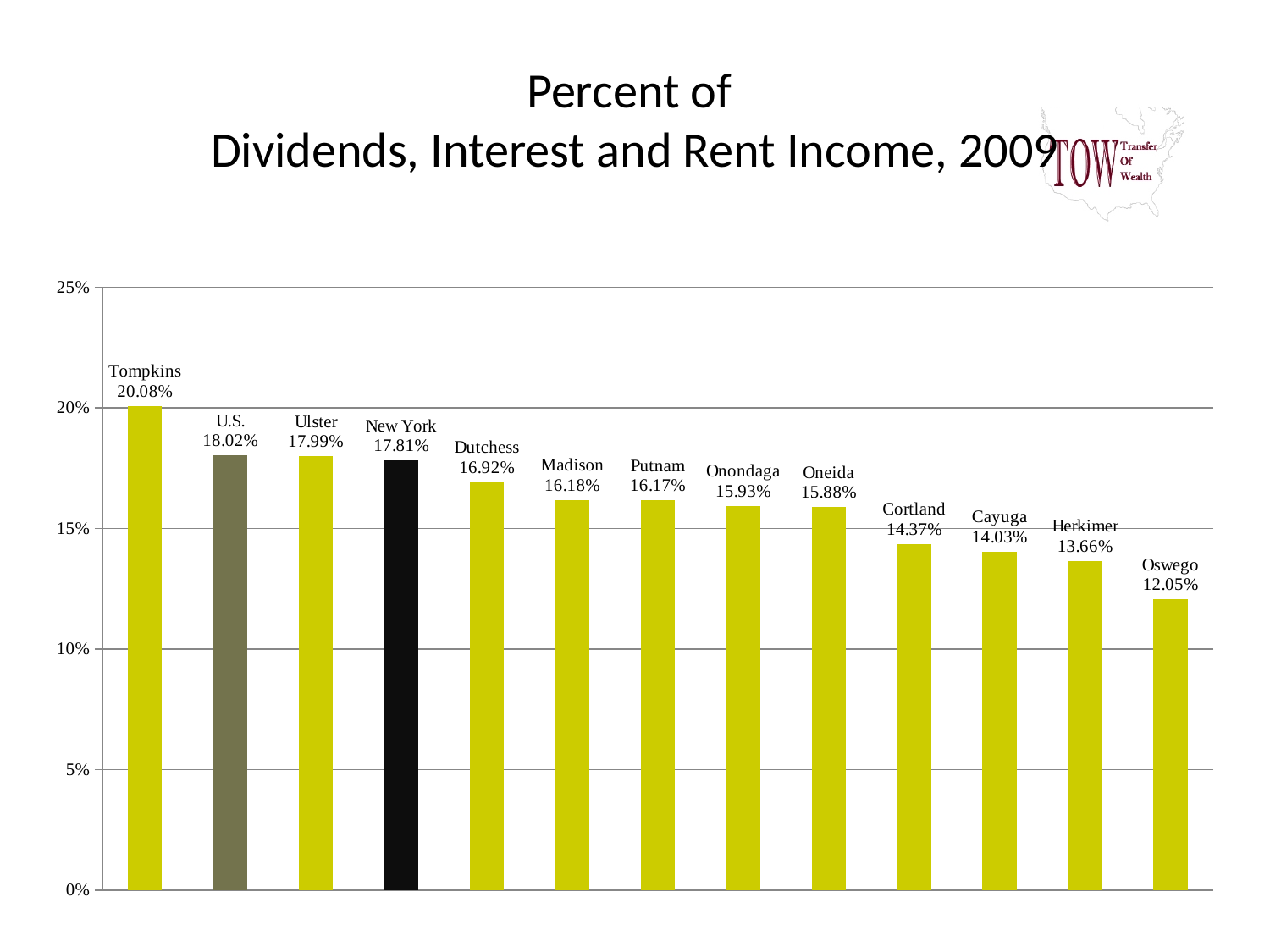
What is the difference between the values for Tompkins and Oswego? 8.03% Do the values rise or fall from left to right along the x axis? fall What is the value for New York? 17.81% What kind of chart is shown on the slide? bar chart What is the value for Tompkins? 20.08% Which category has the lowest value? Oswego Which category has the highest value? Tompkins What is the value for Oneida? 15.88% How many bars are shown in the chart? 13 Is the value for Herkimer greater or less than 15%? less What is the difference between the values for U.S. and New York? 0.21% Which is larger, the value for Dutchess or the value for Cortland? Dutchess